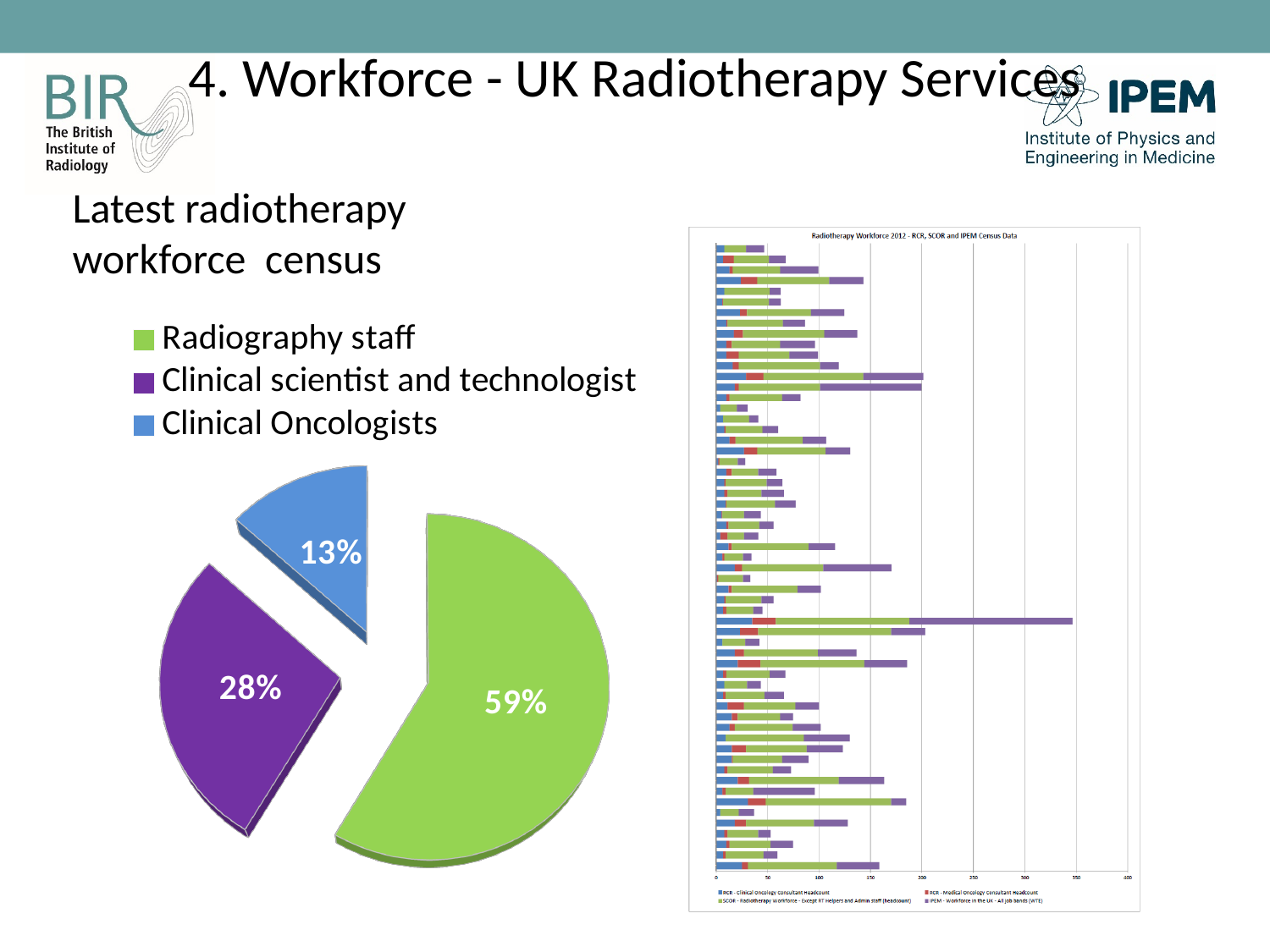
On the pie chart, which is larger: the share for Clinical scientist and technologist or the share for Clinical Oncologists? Clinical scientist and technologist On the pie chart, what colour is the Clinical Oncologists slice? Blue How many entries does the legend of the pie chart list? 3 On the pie chart, what share is shown for Radiography staff? 59% What kind of chart is the chart on the left of the slide? Pie chart On the pie chart, what is the difference in percentage points between Radiography staff and Clinical scientist and technologist? 31 What kind of chart is the chart on the right of the slide? Bar chart On the pie chart, which category has the largest share? Radiography staff On the pie chart, which category has the smallest share? Clinical Oncologists On the pie chart, what share is shown for Clinical scientist and technologist? 28% How many slices does the pie chart have? 3 On the pie chart, what share is shown for Clinical Oncologists? 13%